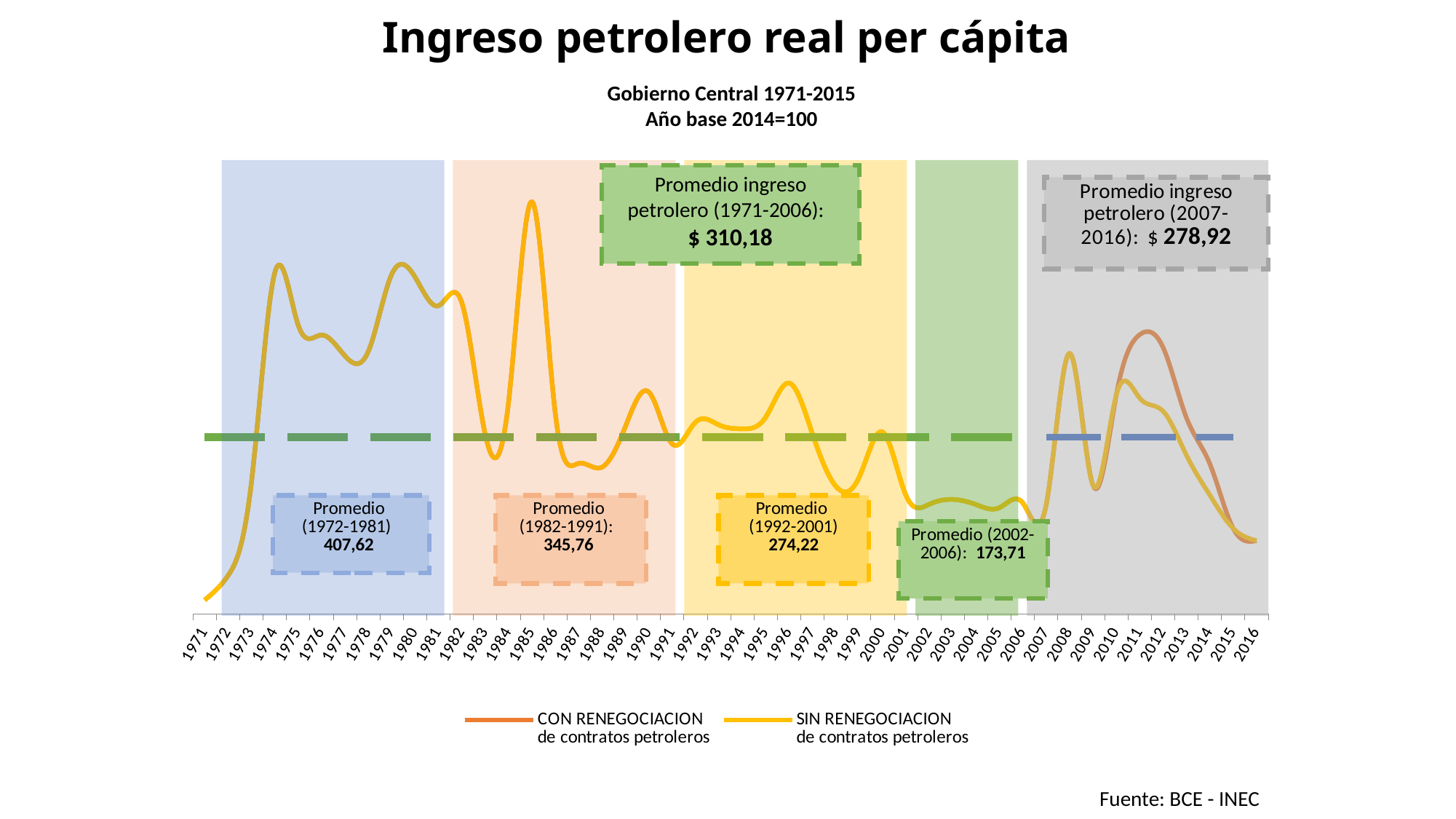
What is the difference between the average for 1972-1981 (407,62) and the average for 1982-1991 (345,76)? 61,86 What is the 'Promedio ingreso petrolero' shown for 2007-2016? $ 278,92 What is the average oil income (Promedio) shown for the period 1972-1981? 407,62 Is the peak of the line in 1985 higher or lower than the peak in 1974? higher Does the line rise or fall from 2012 to 2016? fall Which of the labelled sub-periods (1972-1981, 1982-1991, 1992-2001, 2002-2006) has the highest average? 1972-1981 What is the average oil income (Promedio) shown for the period 1982-1991? 345,76 What is the average oil income (Promedio) shown for the period 2002-2006? 173,71 How many series does the legend list? 2 What kind of chart is shown on the slide? line chart What is the 'Promedio ingreso petrolero' shown for 1971-2006? $ 310,18 Which of the labelled sub-periods (1972-1981, 1982-1991, 1992-2001, 2002-2006) has the lowest average? 2002-2006